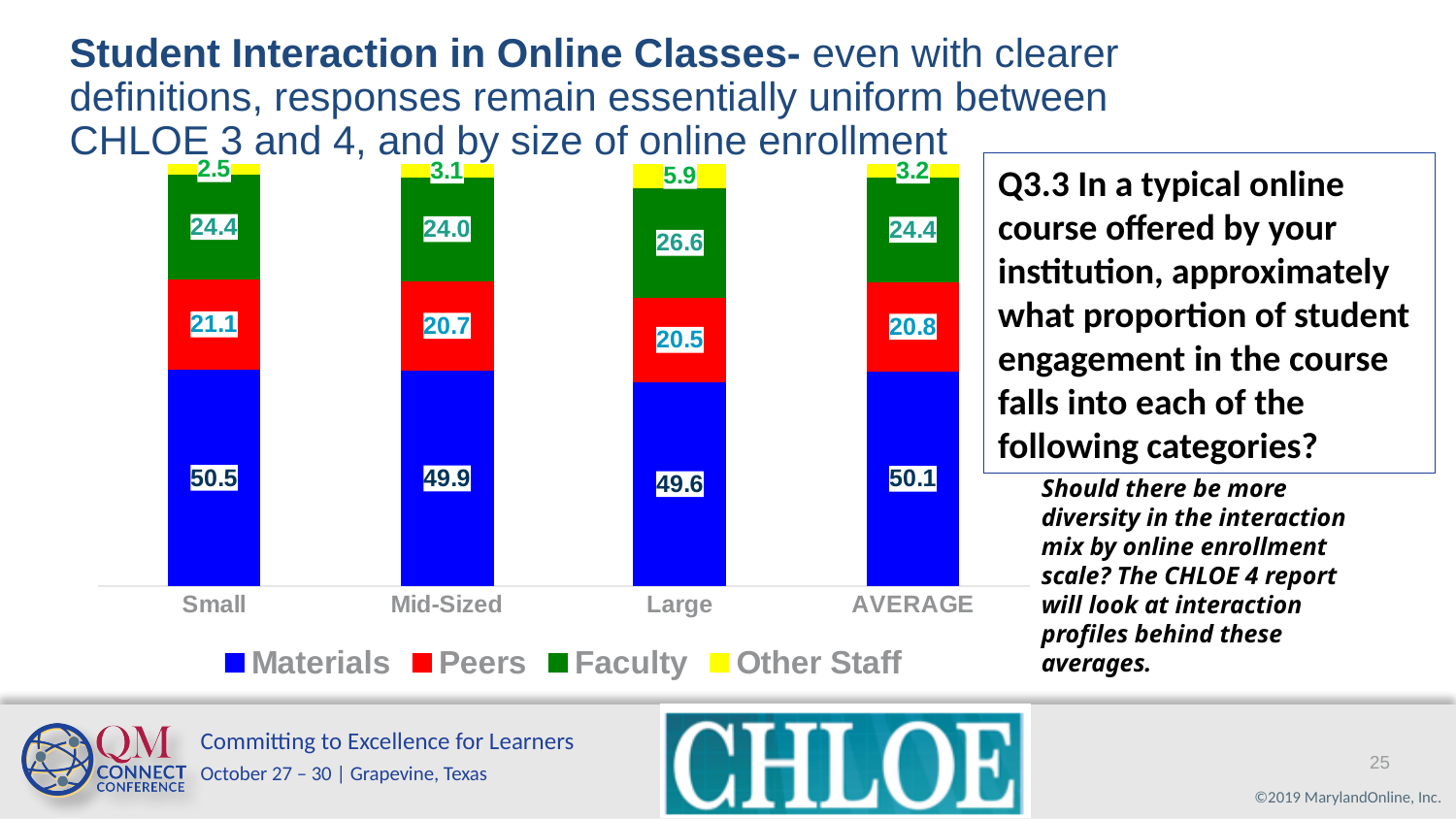
Which is larger, the Peers value for Small or the Peers value for Large? Small How many categories are shown on the x axis? 4 What is the difference between the Faculty values for Large and Small? 2.2 Which colour represents the Peers series in the legend? Red How many series does the legend list? 4 Which category has the highest Other Staff value? Large Which category has the lowest Materials value? Large What is the Peers value for the AVERAGE category? 20.8 What is the Materials value for the Small category? 50.5 What kind of chart is shown on the slide? Stacked bar chart What is the Other Staff value for the Mid-Sized category? 3.1 What is the Faculty value for the Large category? 26.6